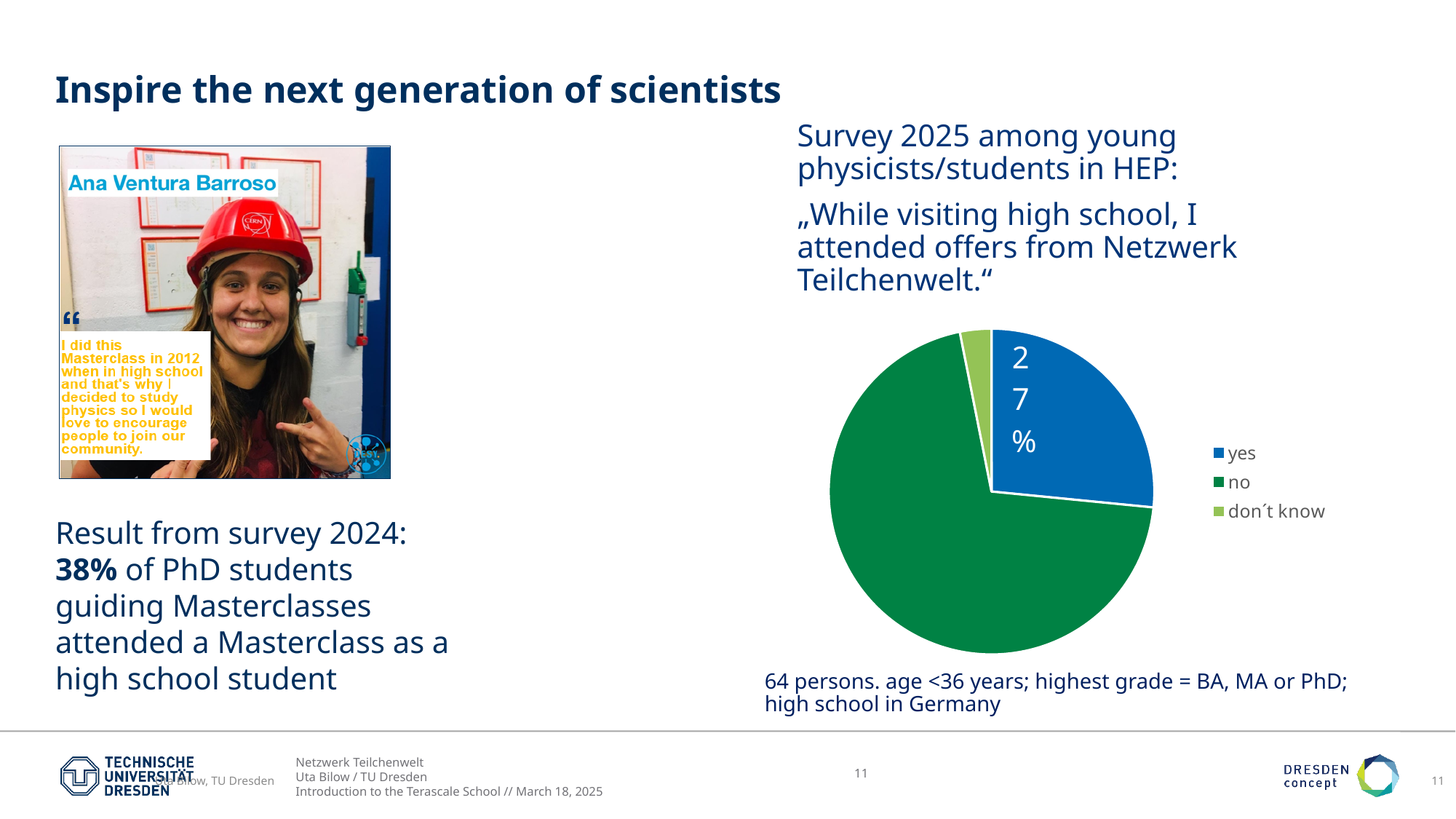
Which category has the largest slice in the pie chart? no Which category has the smallest slice in the pie chart? don´t know What kind of chart is shown on the slide? pie chart What colour is the "yes" slice in the pie chart? blue How many categories are shown in the pie chart? 3 What percentage of respondents answered "yes" in the pie chart? 27% Which slice is larger in the pie chart, "yes" or "no"? no How many entries does the legend of the pie chart list? 3 What share of the pie does the "yes" slice represent? 27% What are the legend entries of the pie chart? yes, no, don´t know Which slice is larger in the pie chart, "yes" or "don´t know"? yes